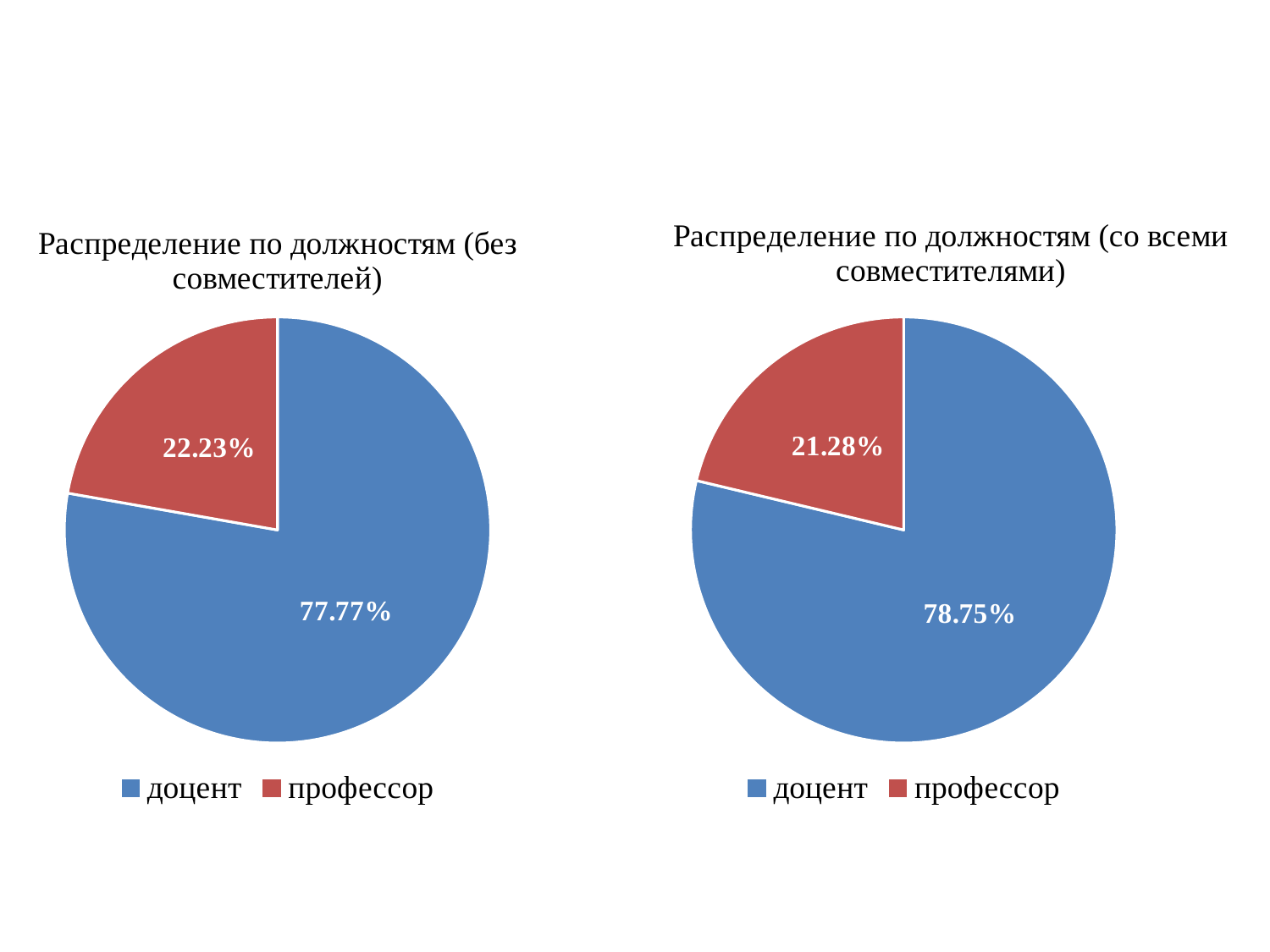
In the right chart (со всеми совместителями), what share is профессор? 21.28% In the left chart (без совместителей), what is the difference between the доцент and профессор shares? 55.54% In the left chart (без совместителей), what colour is the доцент slice? blue In the left chart (без совместителей), what share is доцент? 77.77% In the right chart (со всеми совместителями), what is the difference between the доцент and профессор shares? 57.47% In the right chart (со всеми совместителями), which category has the smallest slice? профессор In the right chart (со всеми совместителями), what share is доцент? 78.75% Which chart shows a larger share for профессор, the left one or the right one? the left one In the left chart (без совместителей), which category has the largest slice? доцент What type of chart is used on the left (без совместителей)? pie chart In the left chart (без совместителей), what share is профессор? 22.23% How many categories does the legend of the right chart (со всеми совместителями) list? 2